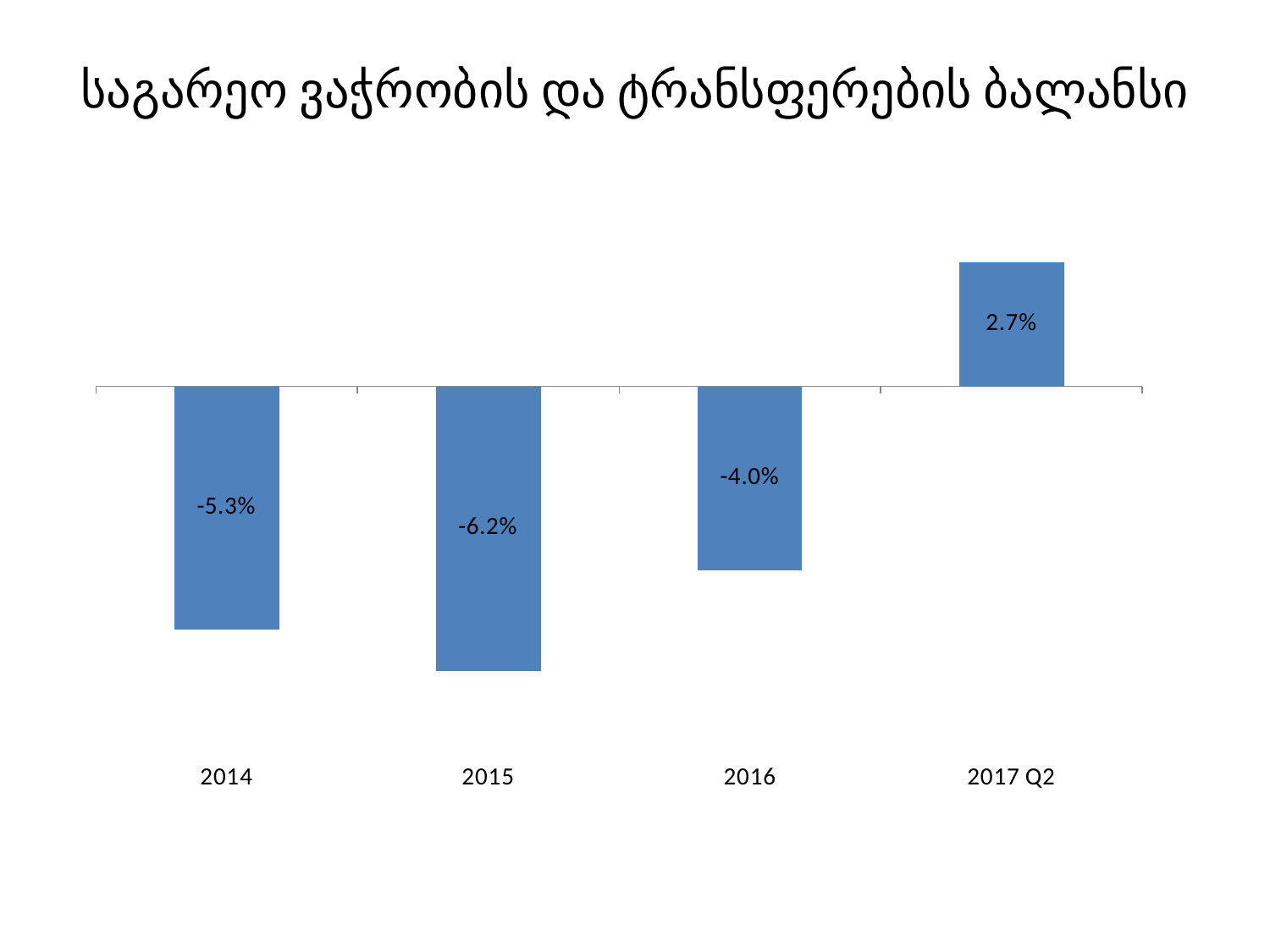
Which category has the highest value? 2017 Q2 What is the value for 2017 Q2? 2.7% Which is larger, the value for 2014 or the value for 2016? 2016 How many bars have a negative value? 3 How many categories are shown on the x axis? 4 What is the value for 2014? -5.3% What is the value for 2016? -4.0% What kind of chart is this? bar chart What is the difference between the values for 2016 and 2015? 2.2% What is the value for 2015? -6.2% Which category has the lowest value? 2015 Do the values rise or fall from 2015 to 2017 Q2? rise